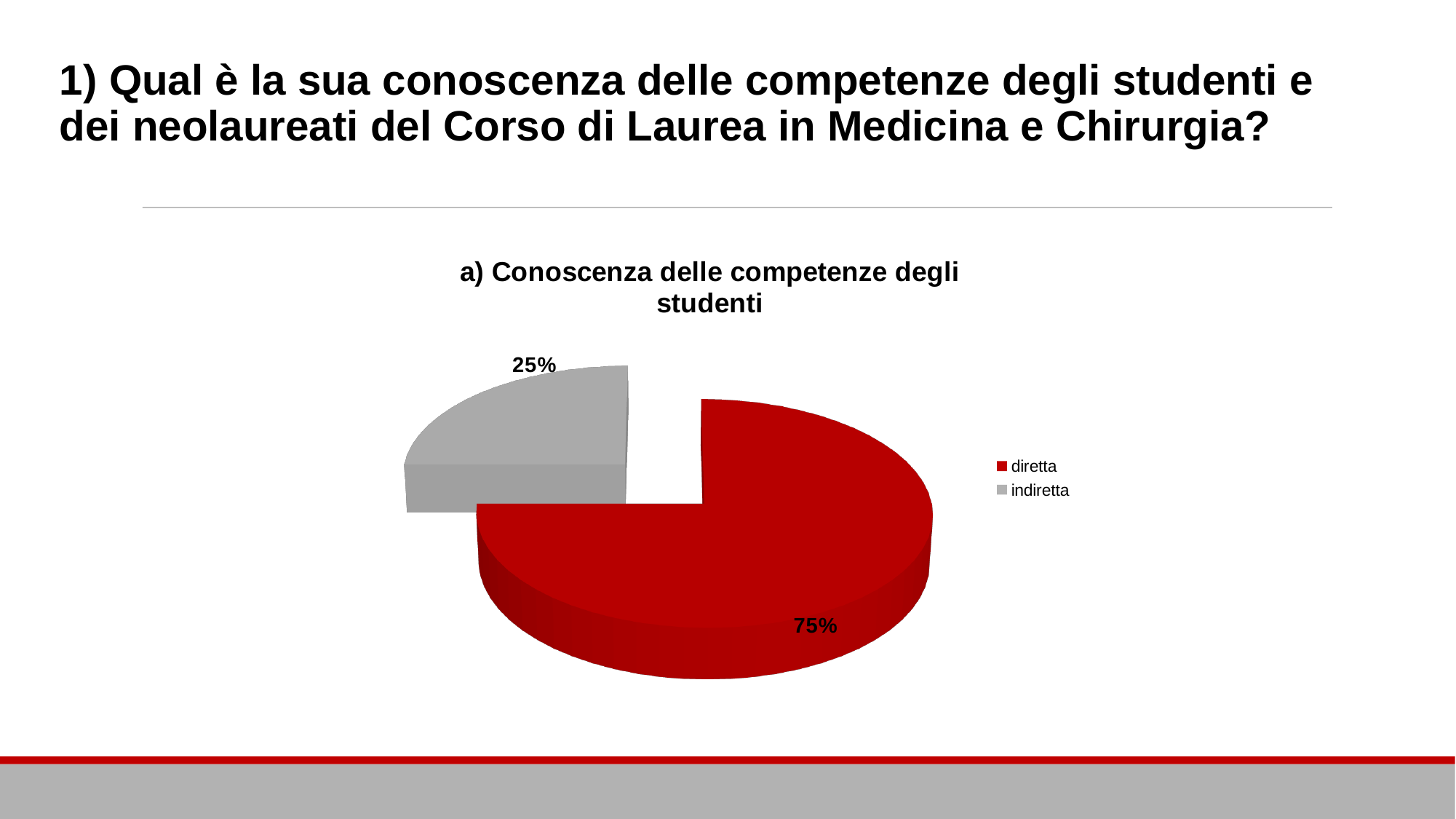
What colour is the slice for 'indiretta'? grey What share of the pie does 'indiretta' represent? 25% What type of chart is shown on the slide? pie chart Which is larger, the slice for 'diretta' or the slice for 'indiretta'? diretta Which category has the smallest slice of the pie? indiretta How many entries does the legend list? 2 What is the difference in percentage points between 'diretta' and 'indiretta'? 50% What is the title of the chart? a) Conoscenza delle competenze degli studenti Which category has the largest slice of the pie? diretta What share of the pie does 'diretta' represent? 75% How many slices does the pie chart have? 2